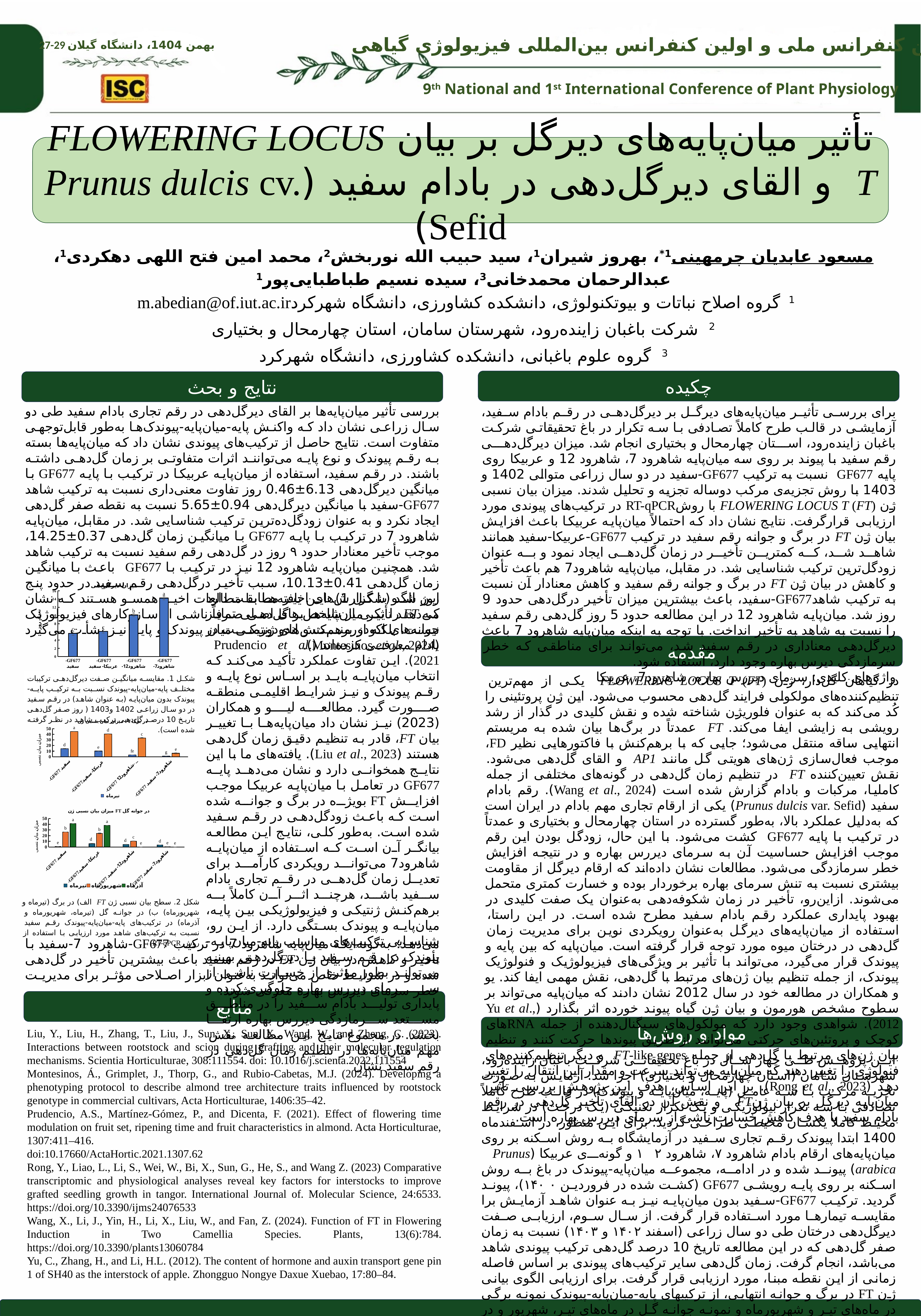
In Figure 1 (the upper chart on the left), how many rootstock/interstock combinations are plotted on the x axis? 4 In Figure 1 (the upper chart on the left), what is the highest tick value shown on the y axis? 16 In Figure 2 (the lower charts on the left), what kind of chart is used? bar chart In Figure 1 (the upper chart on the left), what kind of chart is used? bar chart In Figure 1 (the upper chart on the left), is the value for شاهرود12-GF677-سفید greater or less than 8? greater In Figure 1 (the upper chart on the left), which is larger: the value for شاهرود12-GF677-سفید or the value for GF677-سفید? شاهرود12-GF677-سفید In Figure 1 (the upper chart on the left), is the value for شاهرود7-GF677-سفید greater or less than 12? greater In Figure 2 panel (a) (leaf, the upper of the two lower charts), which combination has the highest relative FT expression? GF677-سفید In Figure 2 (the lower charts on the left), what is the highest tick value shown on the y axis? 50 In Figure 1 (the upper chart on the left), is the value for عربیکا-GF677-سفید greater or less than 8? less In Figure 1 (the upper chart on the left), which combination has the highest mean delay in flowering? شاهرود7-GF677-سفید